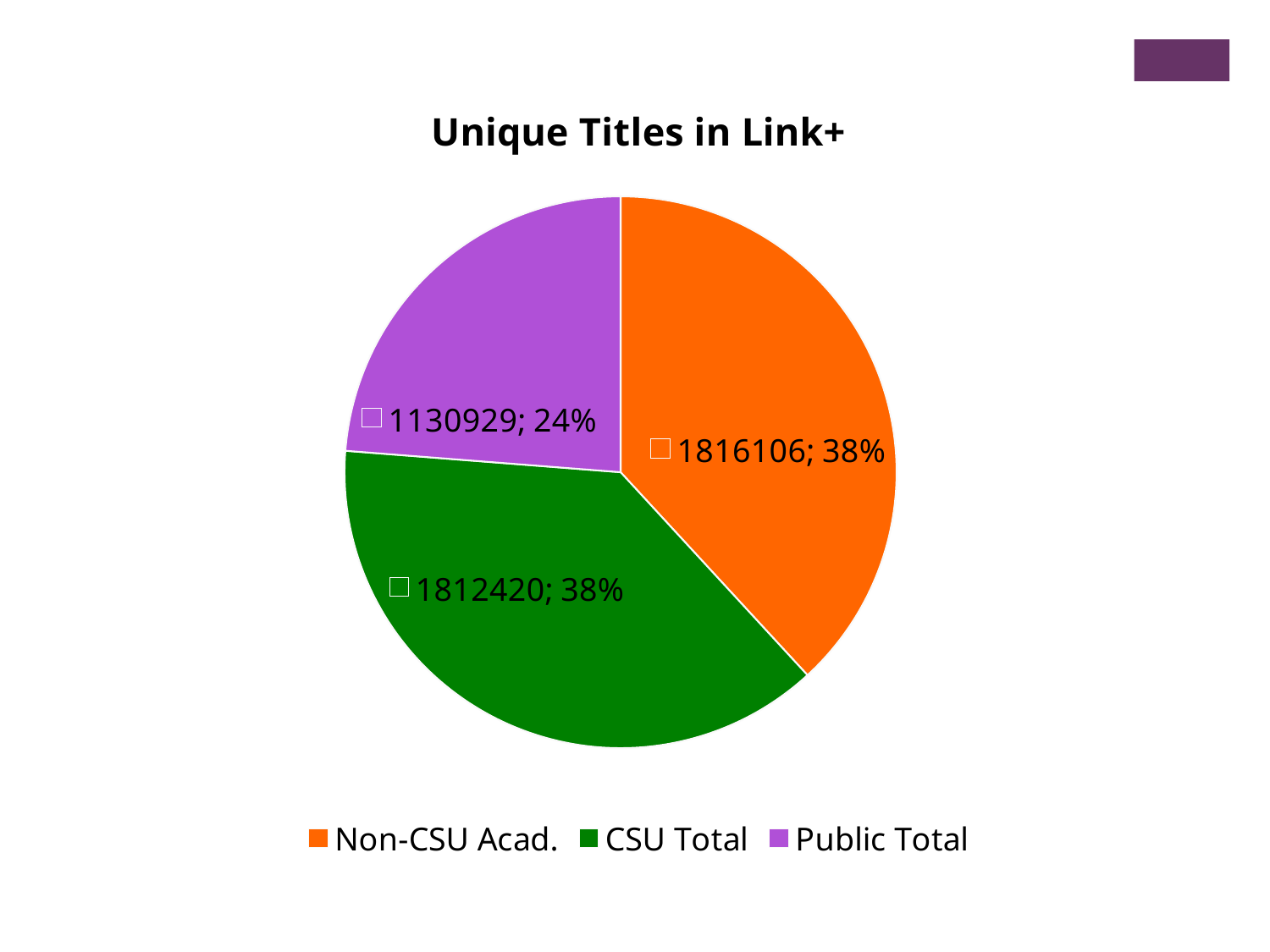
What is the value for Public Total in the Unique Titles in Link+ pie chart? 1130929 What share of the pie does Public Total represent? 24% What share of the pie does Non-CSU Acad. represent? 38% What is the title of the chart on the slide? Unique Titles in Link+ What is the difference between the values for Non-CSU Acad. and Public Total? 685177 Which is larger, the value for CSU Total or the value for Public Total? CSU Total What is the value for Non-CSU Acad. in the Unique Titles in Link+ pie chart? 1816106 What is the difference between the values for Non-CSU Acad. and CSU Total? 3686 Which category has the smallest slice in the Unique Titles in Link+ pie chart? Public Total How many categories are shown in the Unique Titles in Link+ pie chart? 3 What is the value for CSU Total in the Unique Titles in Link+ pie chart? 1812420 What kind of chart is shown on the slide? Pie chart